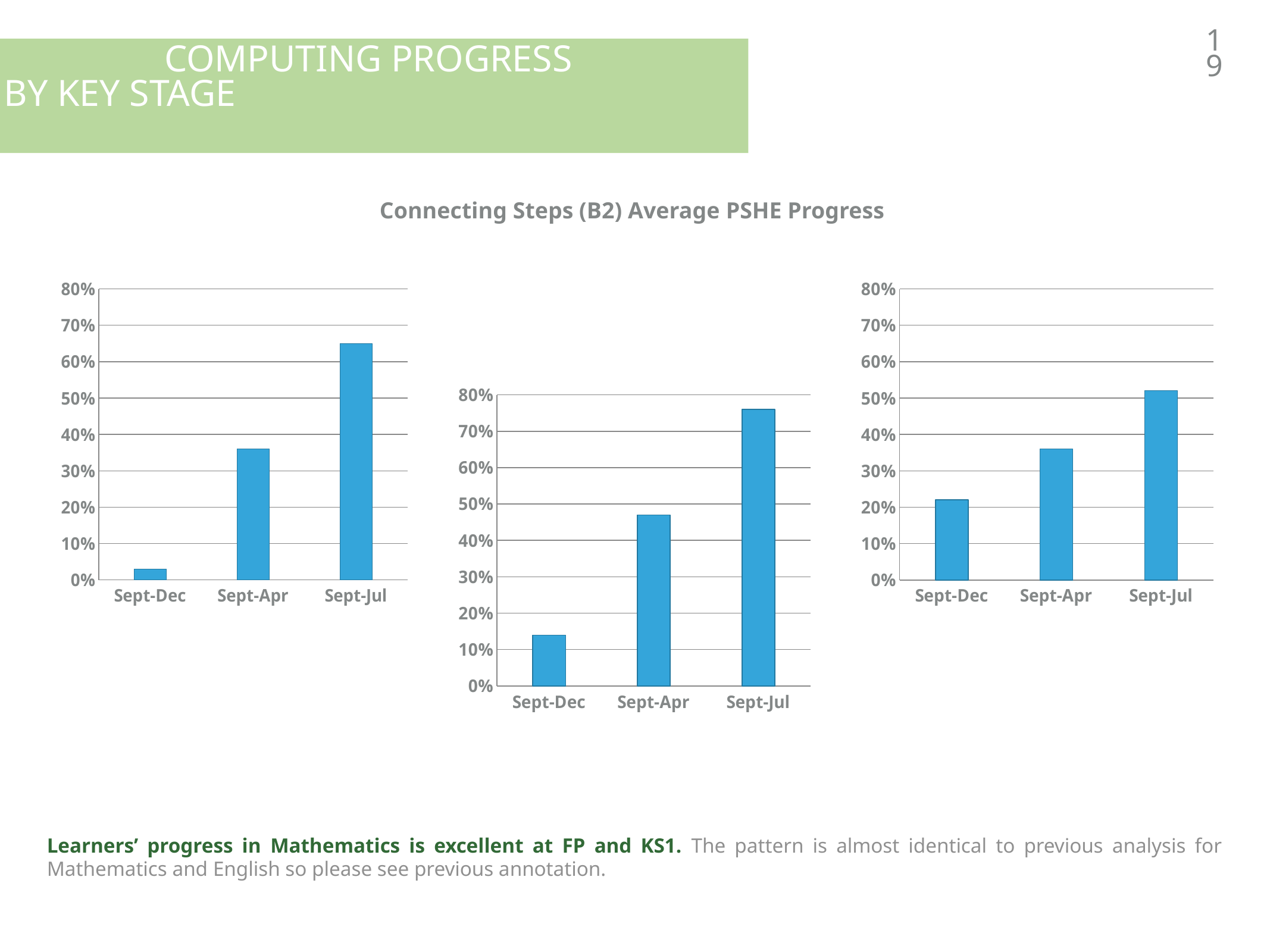
In the left chart, is the value for Sept-Dec greater or less than 10%? less In the left chart, which category has the highest value? Sept-Jul How many categories are shown on the x axis of the middle chart? 3 In the right chart, do the values rise or fall from Sept-Dec to Sept-Jul? rise In the middle chart, which category has the lowest value? Sept-Dec In the right chart, which is larger, the value for Sept-Apr or the value for Sept-Jul? Sept-Jul In the right chart, is the value for Sept-Dec greater or less than 20%? greater In the middle chart, is the value for Sept-Jul greater or less than 70%? greater In the left chart, which category has the lowest value? Sept-Dec What kind of chart is the left chart? bar chart